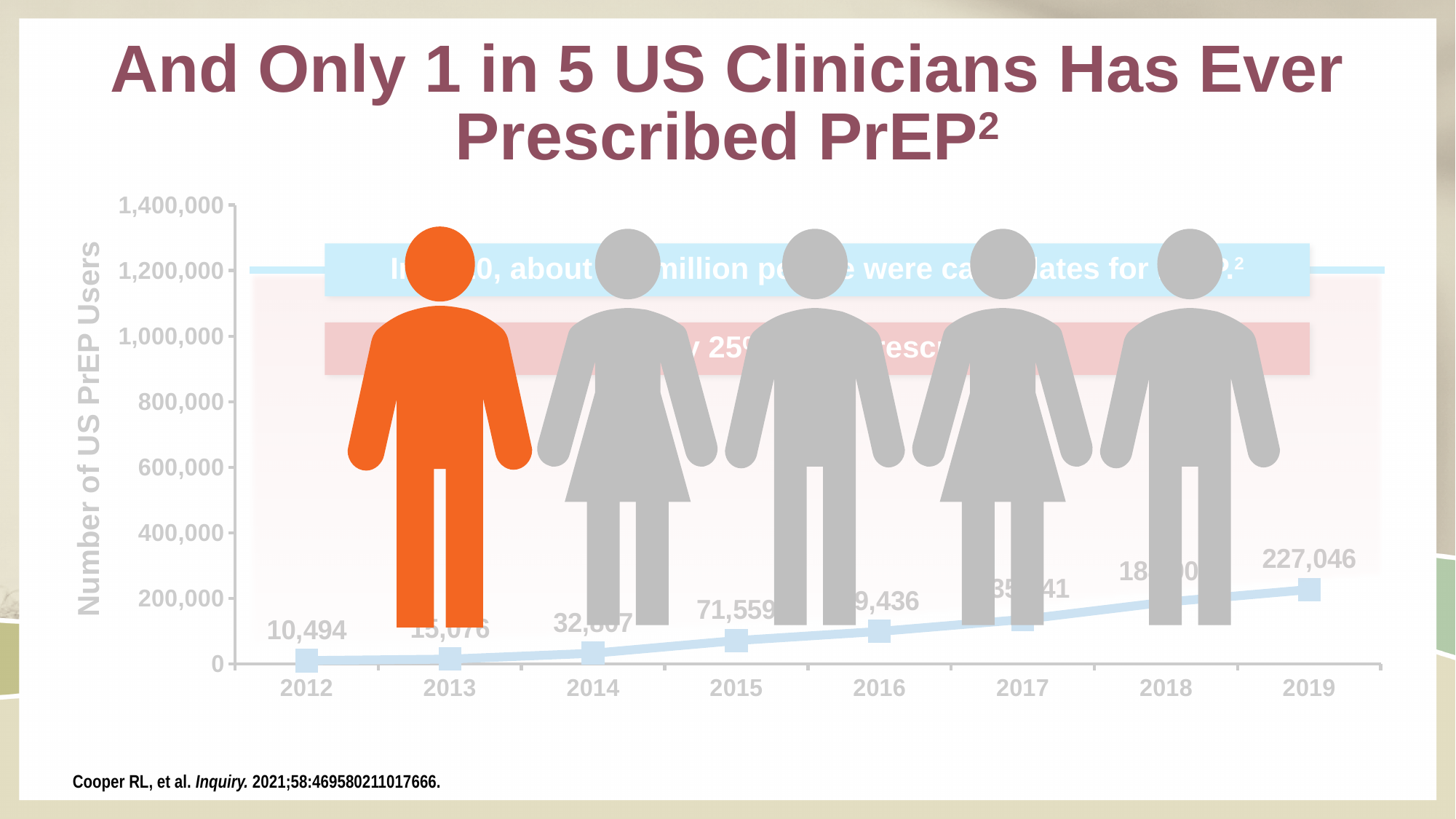
What is the difference between the number of US PrEP users in 2015 and in 2012? 61,065 Do the number of US PrEP users rise or fall from 2012 to 2019? rise What is the number of US PrEP users in 2012? 10,494 Which year has the lowest number of US PrEP users? 2012 What is the difference between the number of US PrEP users in 2019 and in 2012? 216,552 How many years are plotted on the x axis of the chart? 8 What is the number of US PrEP users in 2019? 227,046 Which year has more US PrEP users, 2015 or 2019? 2019 Which year has the highest number of US PrEP users? 2019 What is the number of US PrEP users in 2015? 71,559 What kind of chart is used to show the number of US PrEP users? line chart